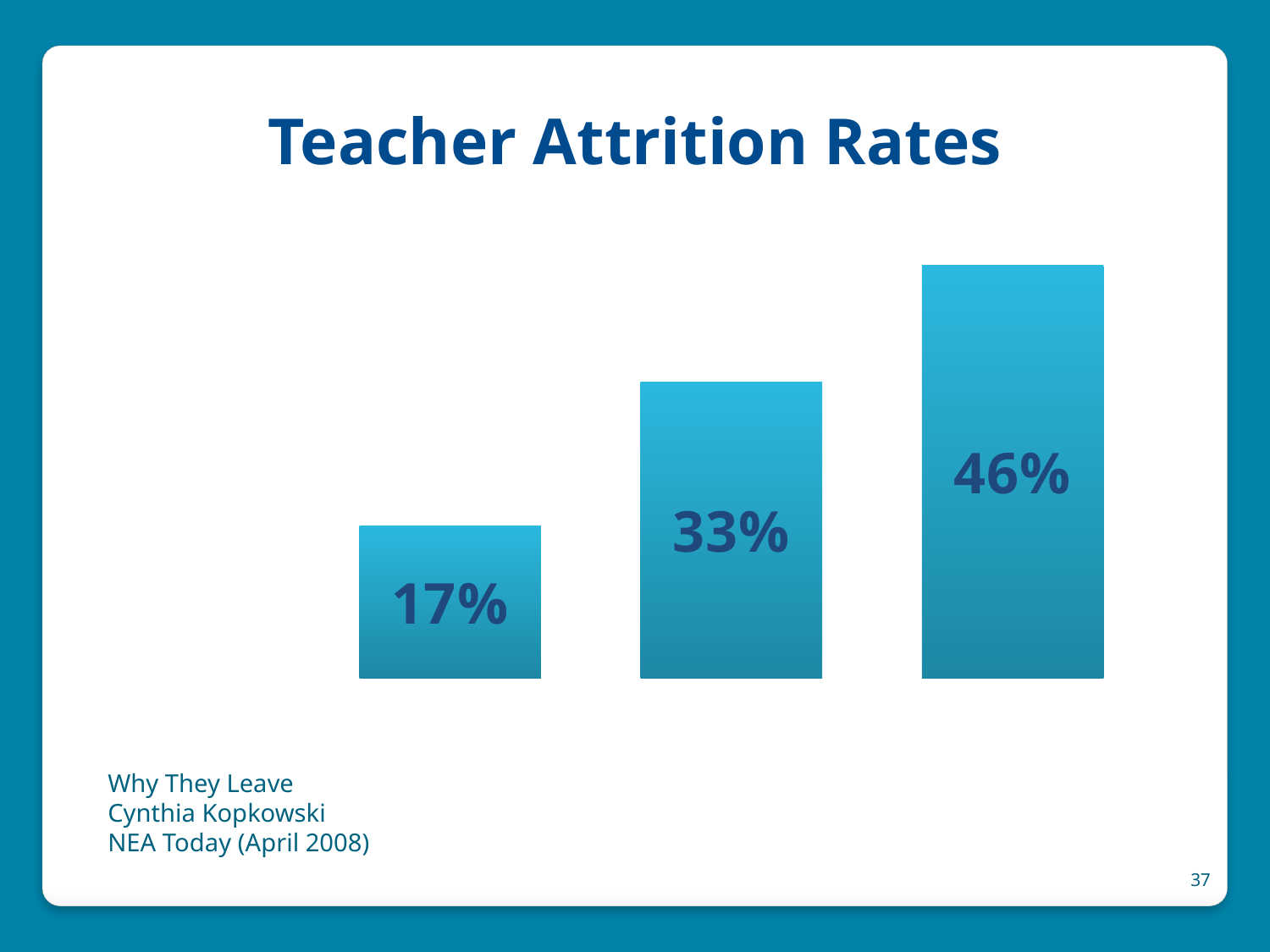
What is the difference between the rightmost bar and the leftmost bar? 29% What is the highest value shown in the chart? 46% Which is larger, the middle bar or the rightmost bar? the rightmost bar How many bars does the chart show? 3 What is the difference between the middle bar and the leftmost bar? 16% What is the lowest value shown in the chart? 17% What value is printed on the middle bar? 33% What kind of chart is shown on the slide? bar chart What is the title of the chart? Teacher Attrition Rates What value is printed on the leftmost bar? 17% What value is printed on the rightmost bar? 46% Do the bar values rise or fall from left to right? rise